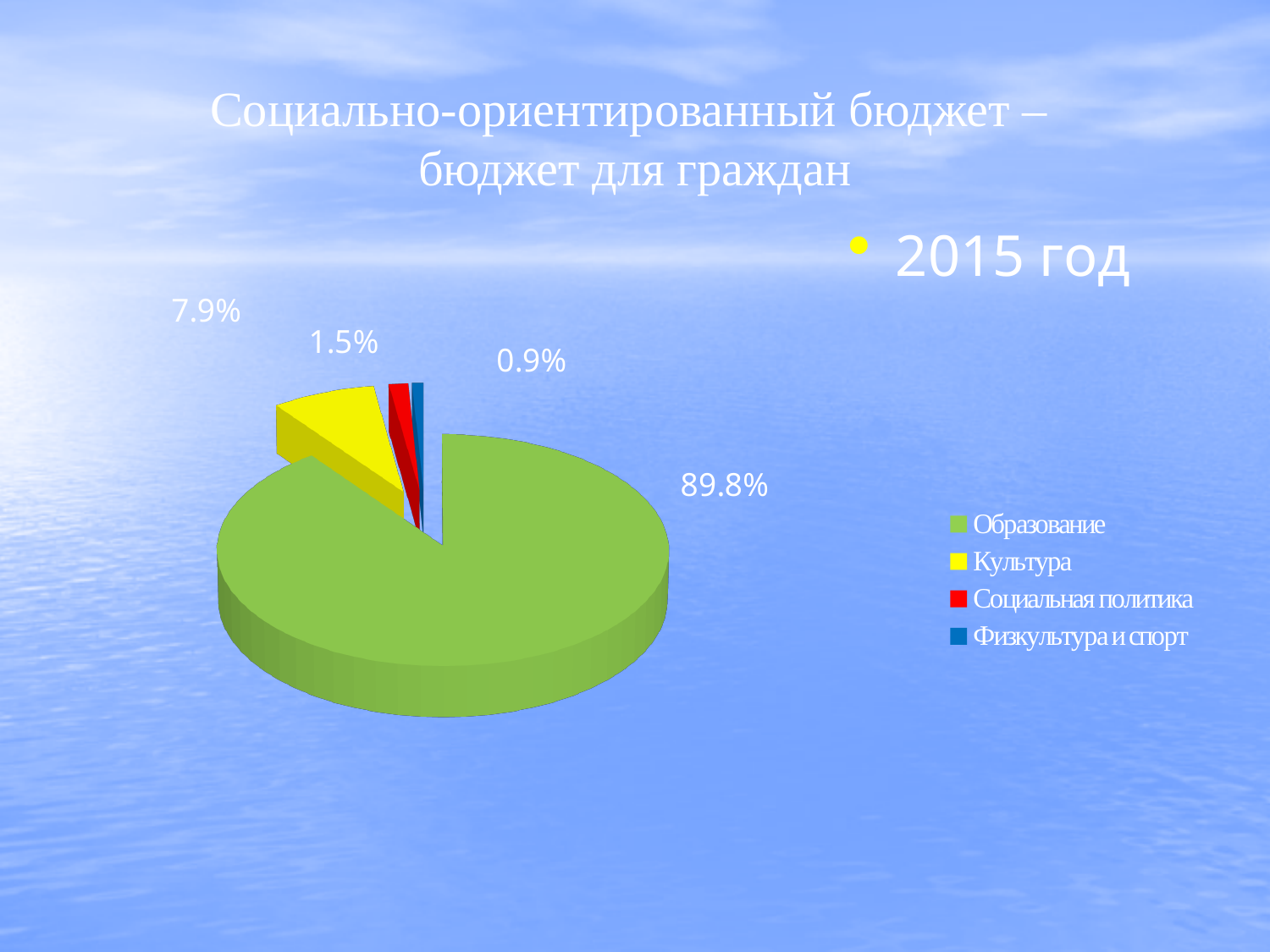
What kind of chart is shown on the slide? Pie chart What share of the pie does Социальная политика have? 1.5% What colour is the slice for Образование? Green What share of the pie does Культура have? 7.9% Which is larger, the share of Культура or the share of Физкультура и спорт? Культура Which category has the largest slice of the pie? Образование Which category has the smallest slice of the pie? Физкультура и спорт What share of the pie does Образование have? 89.8% Which year does the chart refer to, according to the slide? 2015 год What share of the pie does Физкультура и спорт have? 0.9% How many categories does the pie chart have? 4 What is the difference between the shares of Культура and Социальная политика? 6.4%